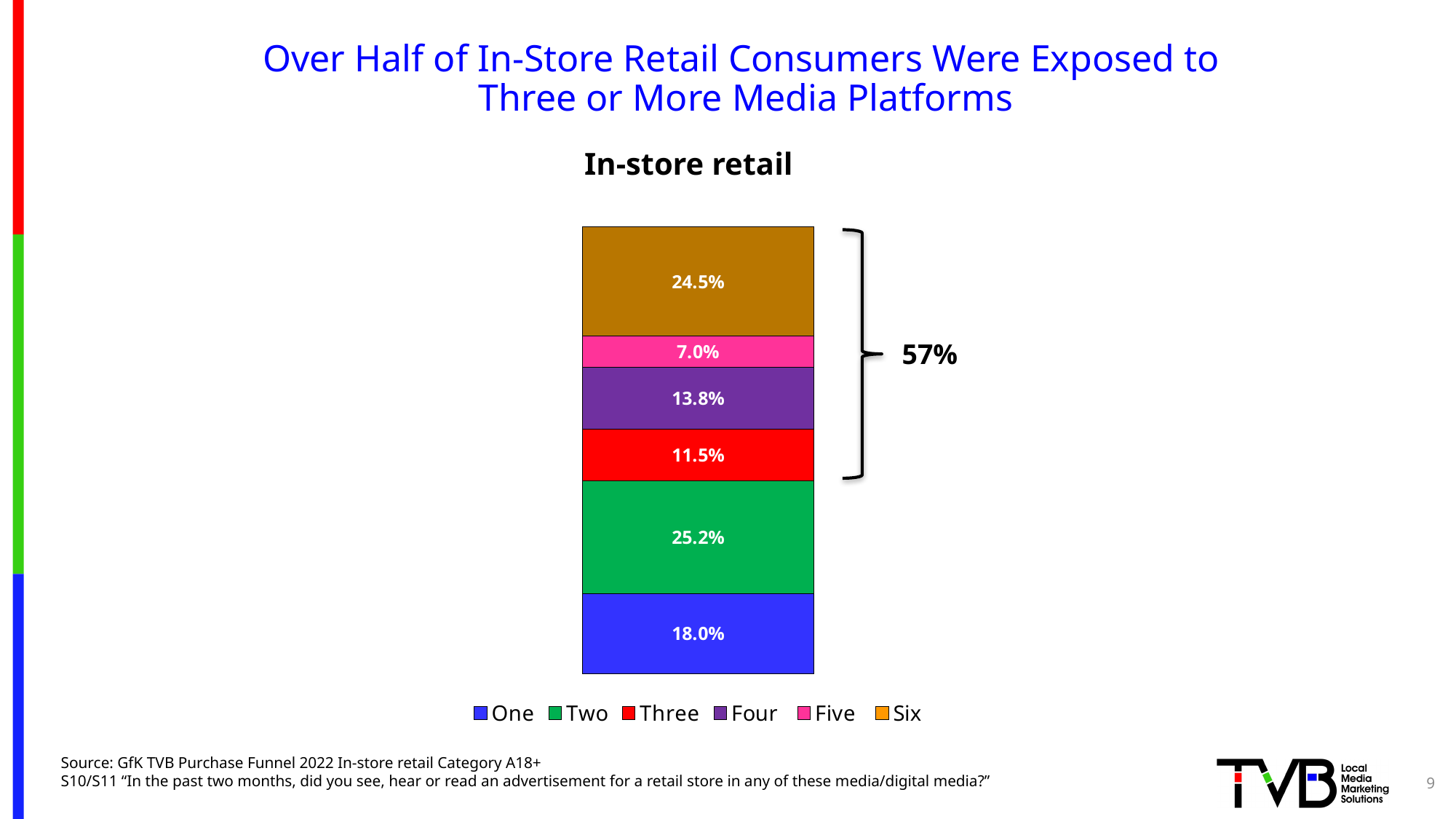
Which series has the smallest segment in the In-store retail bar? Five What is the difference between the "Four" segment and the "Three" segment? 2.3 percentage points What is the difference between the "Six" segment and the "One" segment? 6.5 percentage points Which is larger, the "One" segment or the "Three" segment? One Which series has the largest segment in the In-store retail bar? Two What percentage does the bracket beside the bar label for the Three through Six segments combined? 57% How many series does the legend list? 6 What is the value for the "Six" segment of the In-store retail bar? 24.5% What is the total of all segments in the In-store retail stacked bar? 100.0% What is the value for the "Two" segment of the In-store retail bar? 25.2% What kind of chart is shown on the slide? stacked bar chart What is the value for the "Five" segment of the In-store retail bar? 7.0%